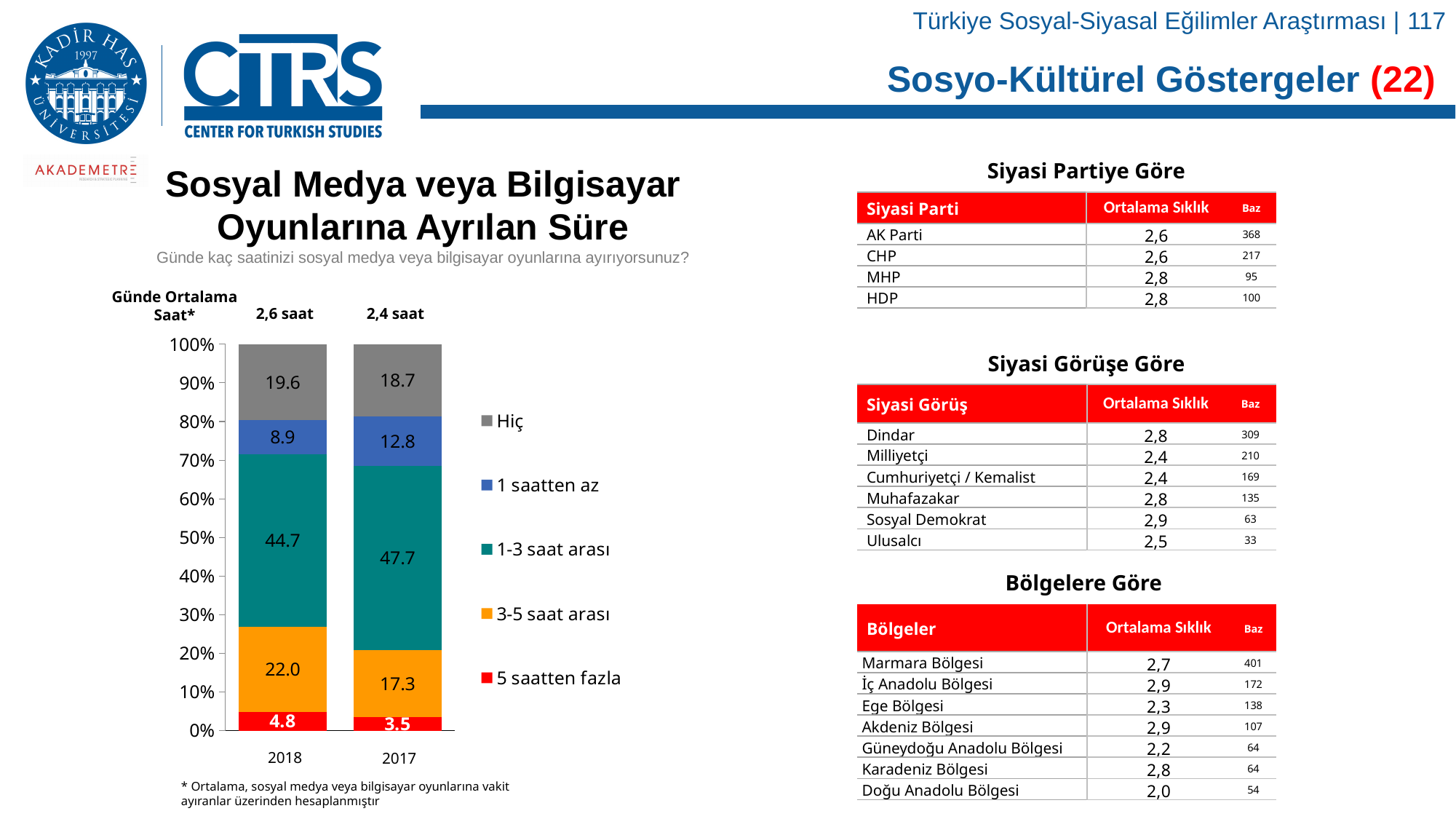
How many bars (years) are plotted in the chart? 2 What kind of chart is shown on the slide? Stacked bar chart Which segment is the largest in the 2017 bar? 1-3 saat arası Which year has the larger '1 saatten az' value, 2018 or 2017? 2017 What is the value of the 'Hiç' segment for 2017? 18.7 What is the difference between the '3-5 saat arası' values for 2018 and 2017? 4.7 How many series does the chart legend list? 5 What average daily hours ('Günde Ortalama Saat') is shown above the 2018 bar? 2,6 saat What is the value of the '5 saatten fazla' segment for 2018? 4.8 What is the value of the '1-3 saat arası' segment for 2018? 44.7 Which segment is the smallest in the 2018 bar? 5 saatten fazla What is the value of the '1 saatten az' segment for 2017? 12.8